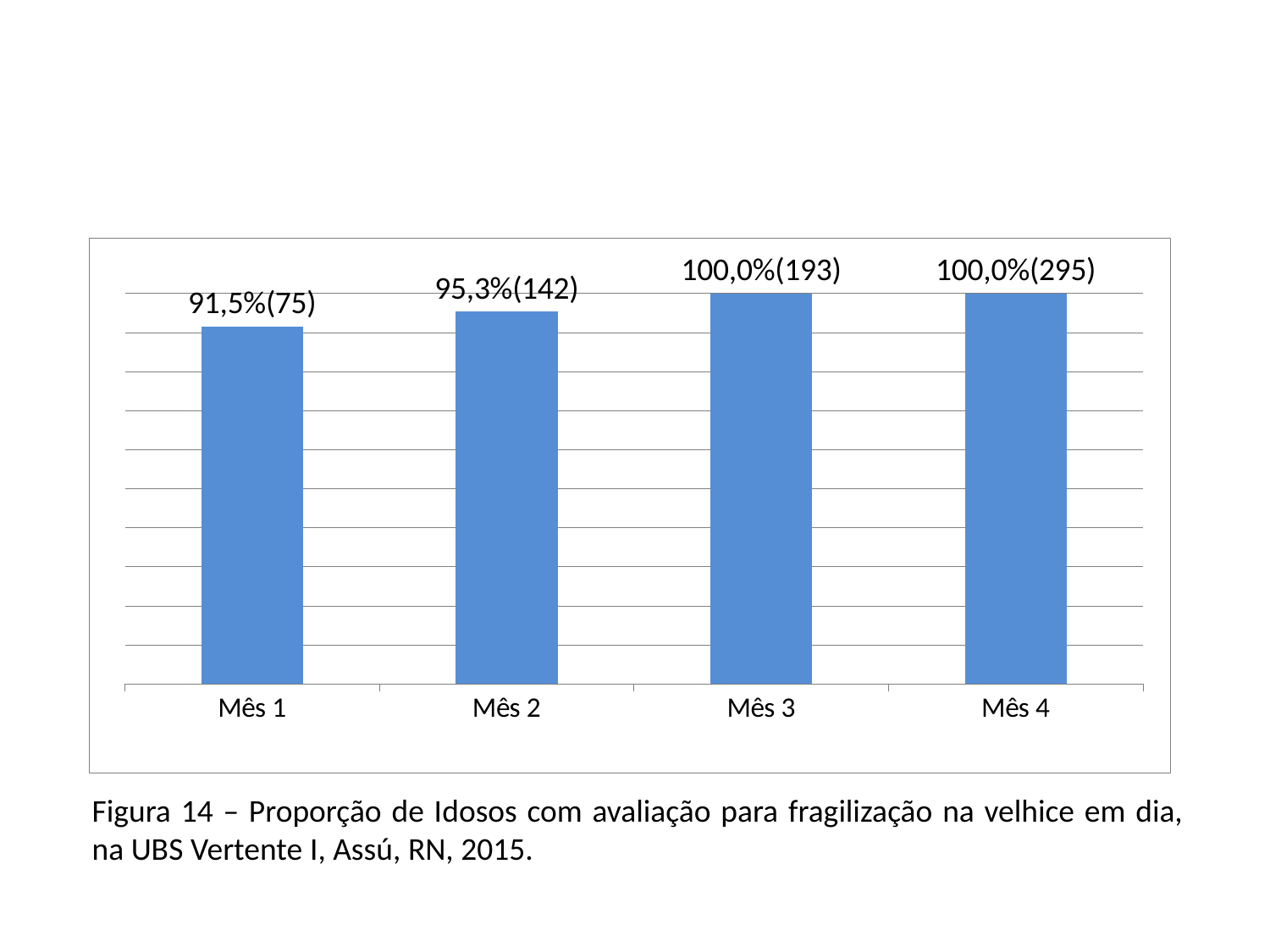
What is the difference in percentage points between Mês 3 and Mês 2? 4,7 What is the data label shown for Mês 3? 100,0%(193) What kind of chart is shown on the slide? Bar chart What is the difference in percentage points between Mês 2 and Mês 1? 3,8 What is the data label shown for Mês 2? 95,3%(142) Do the proportions rise or fall from Mês 1 to Mês 4? Rise Which month has the lowest proportion? Mês 1 Which is larger, the proportion for Mês 1 or for Mês 2? Mês 2 How many months (categories) are shown on the x axis? 4 What figure number is given in the caption below the chart? Figura 14 What is the data label shown for Mês 1? 91,5%(75) What is the data label shown for Mês 4? 100,0%(295)